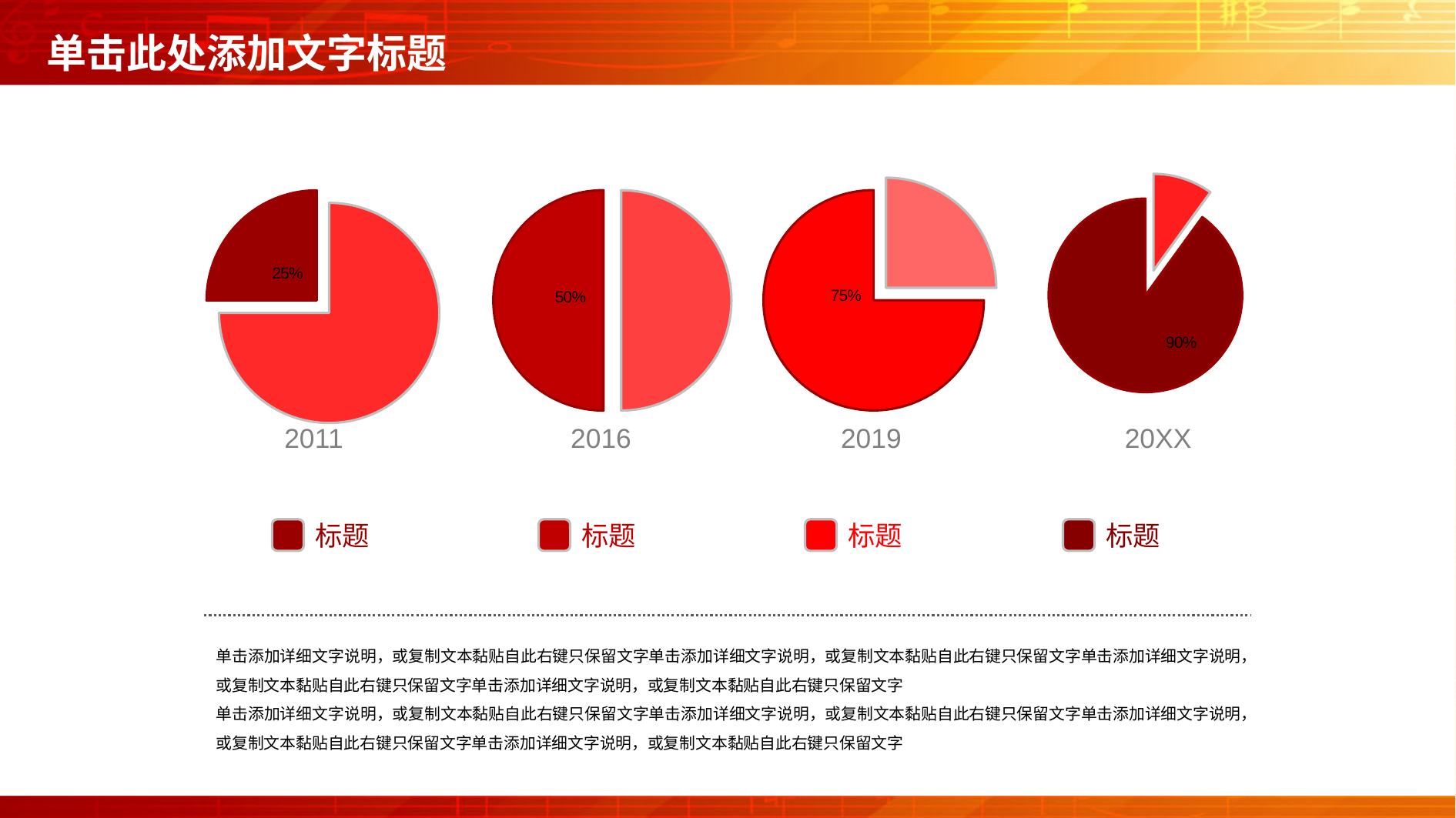
In the pie chart labelled 2019, what percentage is printed on the larger slice? 75% In the pie chart labelled 2011, what percentage is printed on the smaller slice? 25% Which pie chart has the larger printed percentage, 2016 or 2019? 2019 What kind of chart is used for each of the four charts on the slide? pie chart Do the printed percentages rise or fall going from the leftmost pie chart (2011) to the rightmost (20XX)? rise In the pie chart labelled 2016, what percentage is printed on the chart? 50% How many pie charts are shown on the slide? 4 In the pie chart labelled 20XX, what percentage is printed on the larger slice? 90% What label appears beneath the rightmost pie chart? 20XX Which pie chart shows the largest printed percentage? 20XX Which pie chart shows the smallest printed percentage? 2011 What is the difference between the percentage printed on the 2019 pie chart and the percentage printed on the 2011 pie chart? 50%